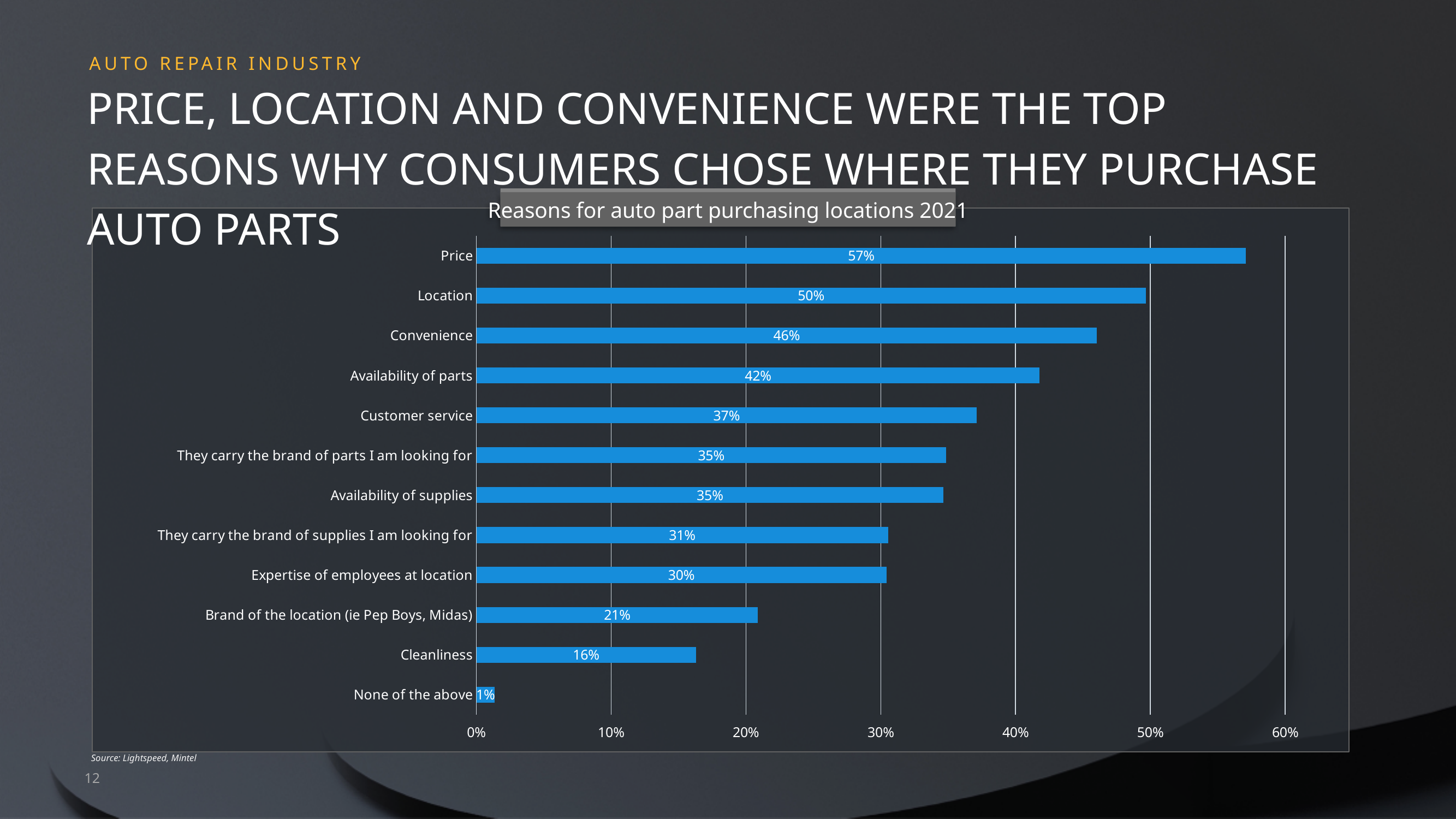
What is the difference between the values for Price and Location? 7% What is the value for Price? 57% What kind of chart is shown on the slide? Bar chart Which category has the highest value? Price What is the title of the chart? Reasons for auto part purchasing locations 2021 What is the value for Brand of the location (ie Pep Boys, Midas)? 21% What is the value for Cleanliness? 16% Which category has the lowest value? None of the above What is the difference between the values for Convenience and Cleanliness? 30% What is the value for Customer service? 37% How many categories are shown in the chart? 12 Which is larger, the value for Availability of parts or the value for Expertise of employees at location? Availability of parts